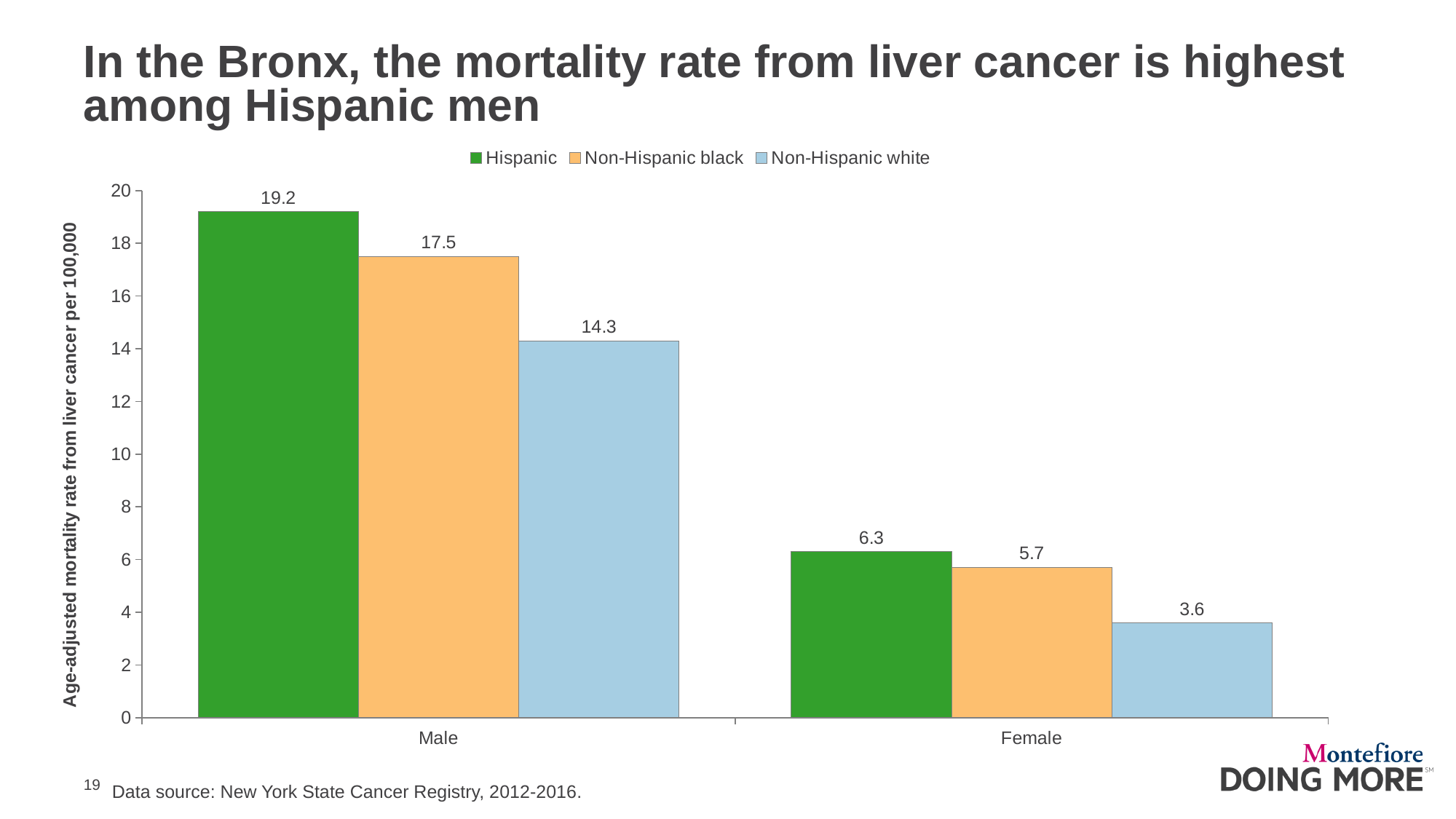
What is the age-adjusted liver cancer mortality rate for Non-Hispanic white females? 3.6 Which group has the highest mortality rate on the chart? Hispanic males How many categories are shown on the x axis? 2 What kind of chart is shown on the slide? Bar chart Which group has the lowest mortality rate on the chart? Non-Hispanic white females How many series does the legend list? 3 What is the difference between the Hispanic female rate and the Non-Hispanic black female rate? 0.6 What is the age-adjusted liver cancer mortality rate for Hispanic males? 19.2 Is the value for Non-Hispanic white males greater or less than 12? greater What is the difference between the Hispanic male rate and the Non-Hispanic white male rate? 4.9 Which is larger, the Non-Hispanic black female rate or the Non-Hispanic white female rate? Non-Hispanic black female What is the value for Non-Hispanic black males? 17.5